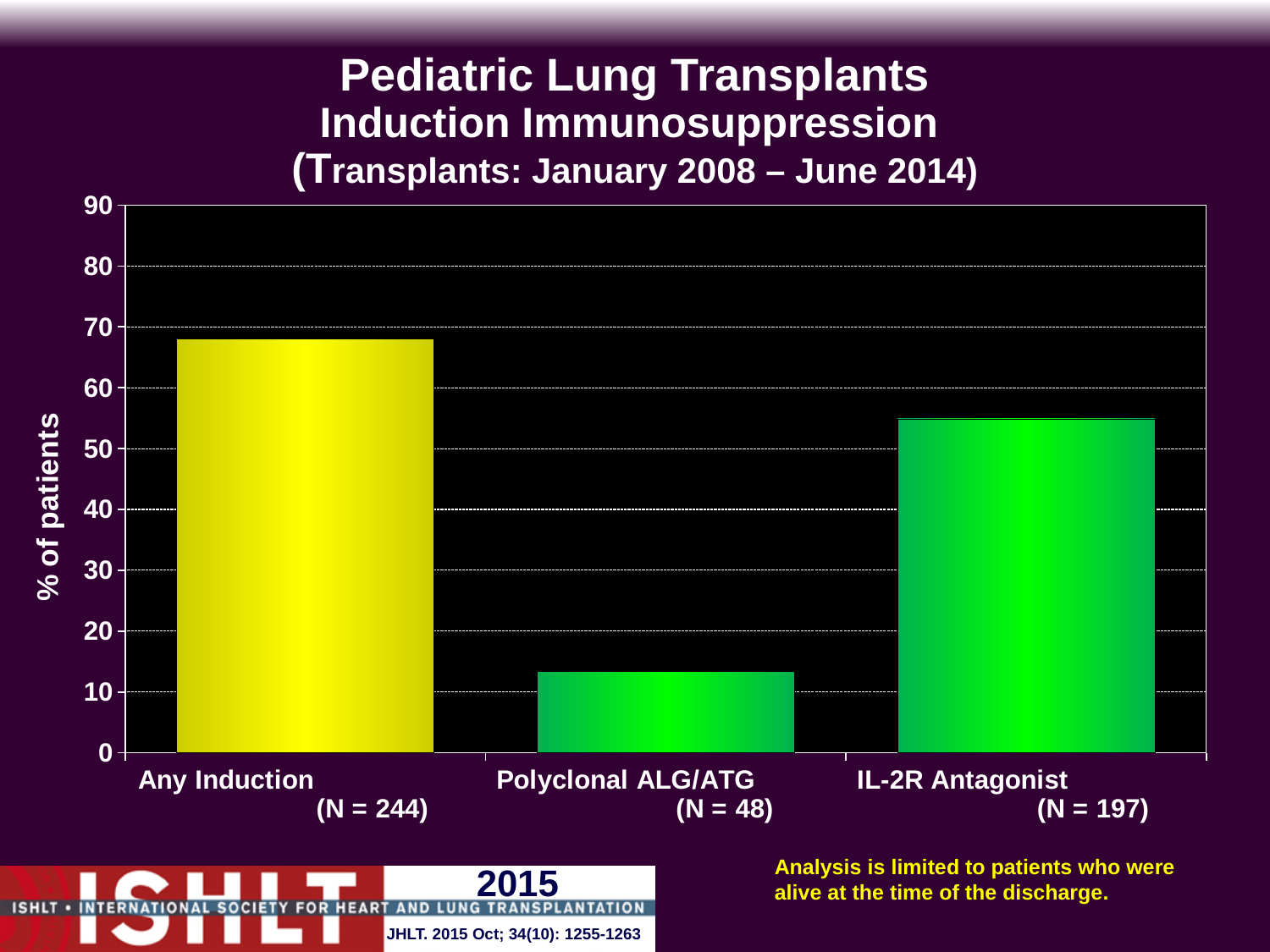
Which is larger, the value for IL-2R Antagonist or the value for Polyclonal ALG/ATG? IL-2R Antagonist What is the N shown for the Polyclonal ALG/ATG category? N = 48 How many categories are shown on the x axis? 3 Is the value for IL-2R Antagonist greater or less than 50? greater Which category has the highest value? Any Induction Is the value for Any Induction greater or less than 60? greater Is the value for IL-2R Antagonist greater or less than 60? less What kind of chart is shown on the slide? bar chart Which is larger, the value for Any Induction or the value for IL-2R Antagonist? Any Induction What is the label of the y axis? % of patients Which category has the lowest value? Polyclonal ALG/ATG